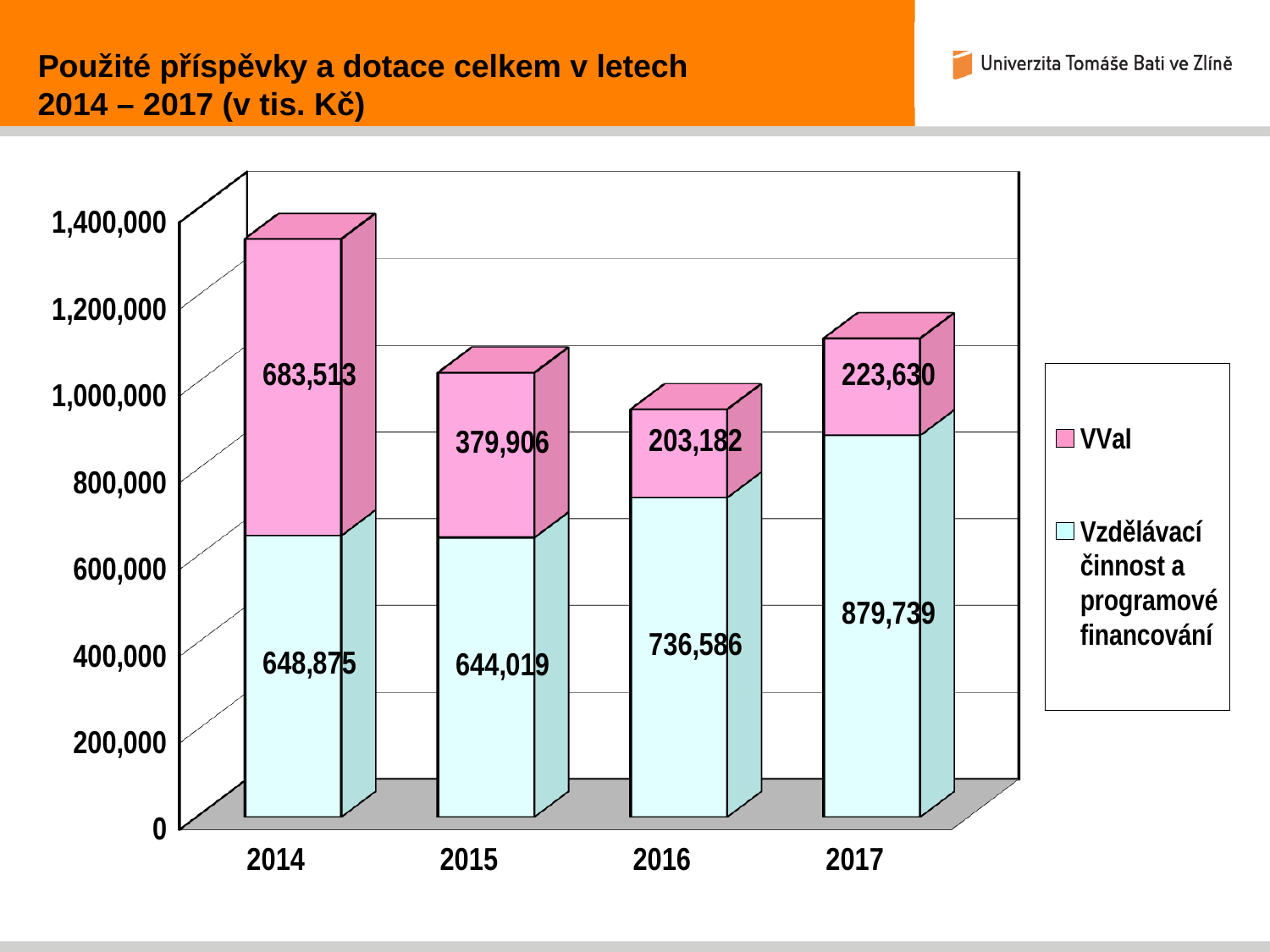
Which is larger: Vzdělávací činnost a programové financování in 2015 or in 2016? 2016 In which year is the VVaI value the highest? 2014 What type of chart is shown on the slide? stacked bar chart How many series does the legend list? 2 Is the total of the stacked bar for 2017 greater or less than 1,000,000? greater What is the total of the stacked bar for 2016? 939,768 What is the value for Vzdělávací činnost a programové financování in 2017? 879,739 How many years (categories) are shown on the x axis? 4 In which year is the VVaI value the lowest? 2016 What is the value for VVaI in 2016? 203,182 What is the difference between the VVaI values for 2014 and 2015? 303,607 What is the value for VVaI in 2014? 683,513